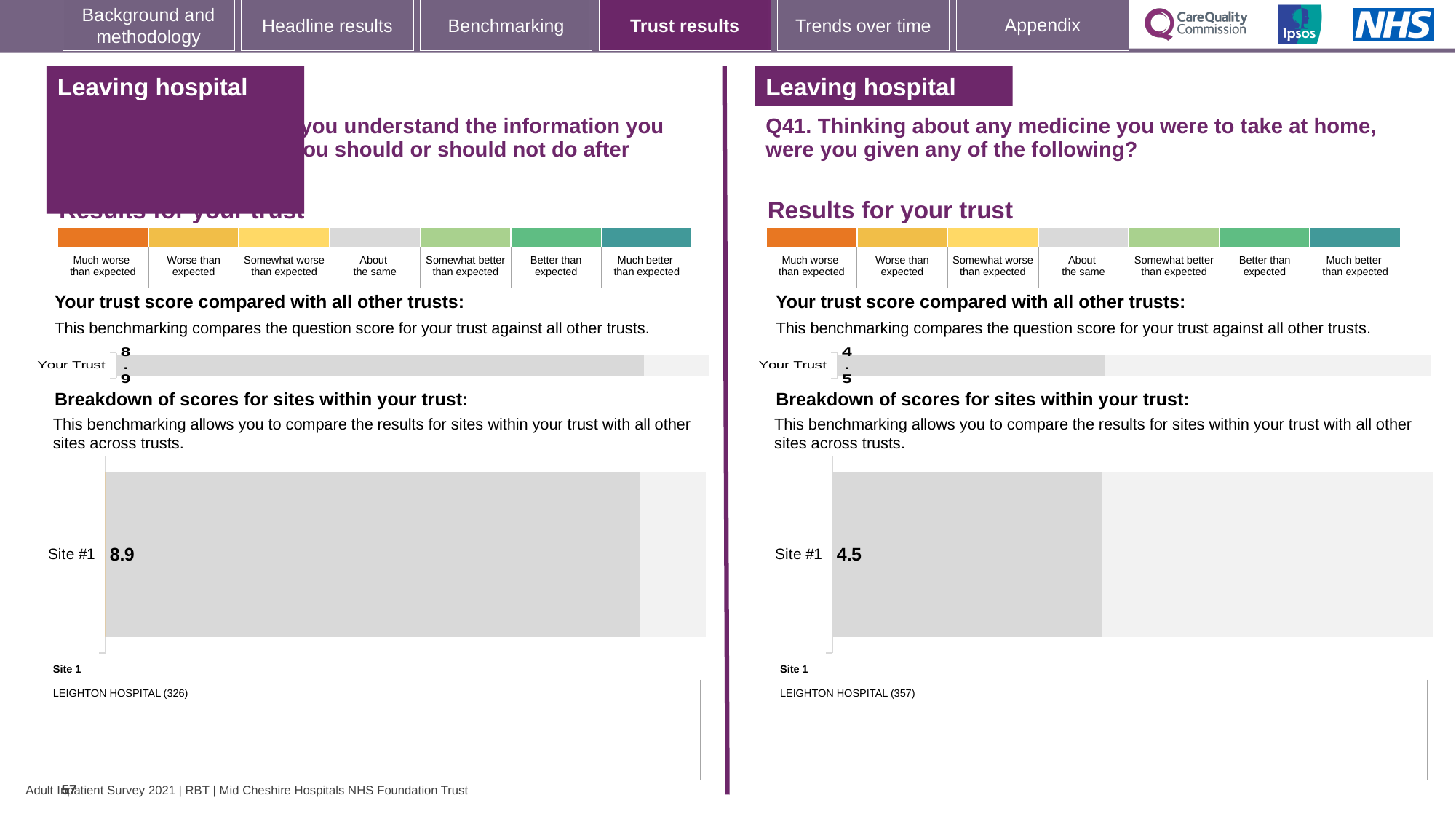
Which is larger: the Your Trust score on the left-hand chart or the Your Trust score on the right-hand chart (Q41)? Left-hand chart (8.9) Is the Site #1 score on the left-hand chart greater or less than 8? greater On the left-hand chart, what is the score shown for Site #1? 8.9 Is the Site #1 score on the right-hand chart (Q41) greater or less than 5? less On the right-hand chart (Q41), what is the score shown for Site #1? 4.5 On the right-hand chart (Q41), which site is listed as Site 1? LEIGHTON HOSPITAL (357) What is the difference between the Site #1 score on the left-hand chart and the Site #1 score on the right-hand chart (Q41)? 4.4 How many sites are shown in the site breakdown chart on the right-hand side (Q41)? 1 What type of chart is used to show the Site #1 score on the left-hand side? Bar chart On the left-hand chart, what is the score shown for Your Trust? 8.9 On the right-hand chart (Q41), what is the score shown for Your Trust? 4.5 On the left-hand chart, which site is listed as Site 1? LEIGHTON HOSPITAL (326)